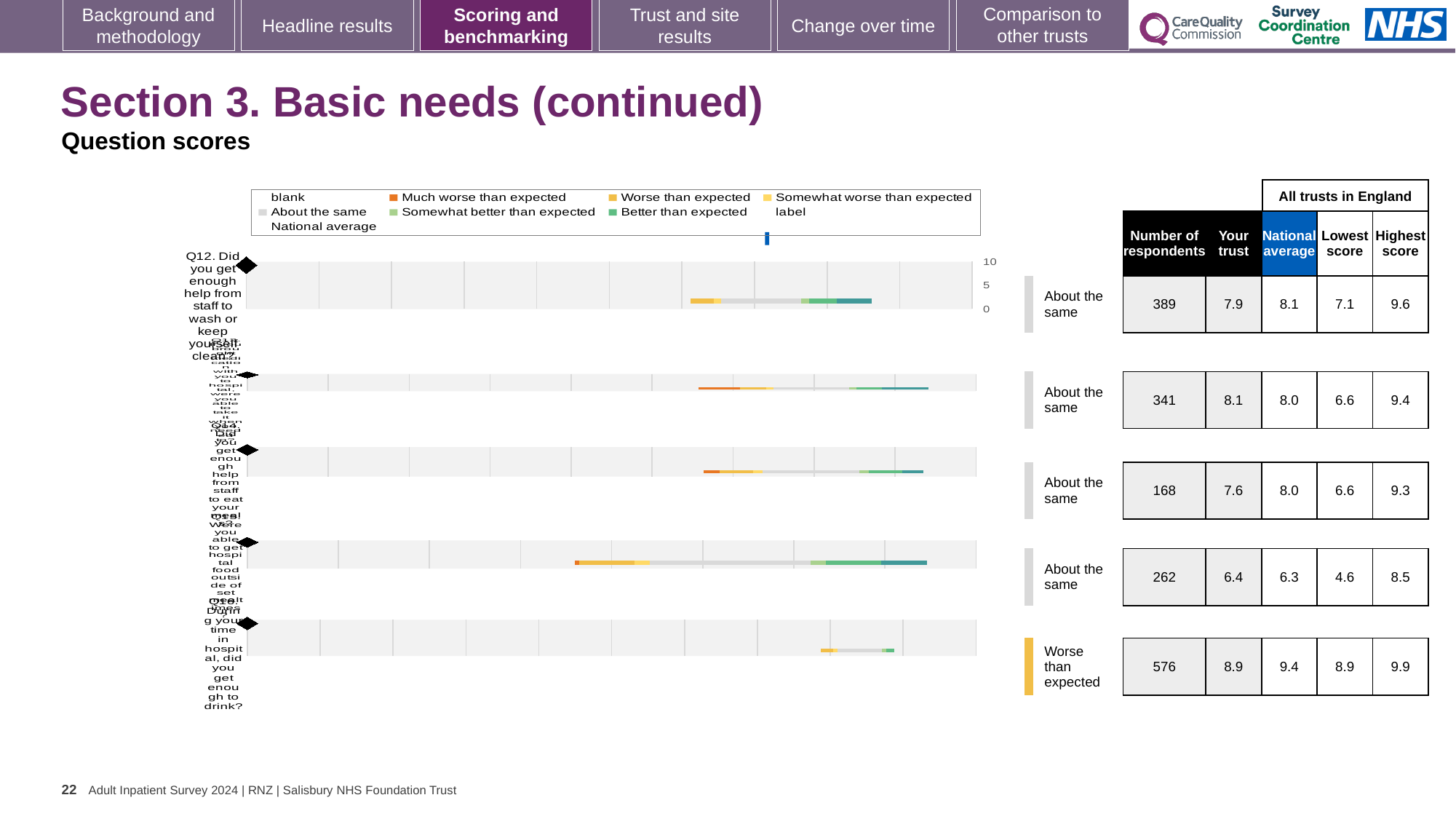
What benchmark category is shown for the first row (Q12, help from staff to wash or keep yourself clean)? About the same What is the difference between the highest score and lowest score for the first row (Q12)? 2.5 How many horizontal bars (question rows) are plotted in the chart? 5 What is the maximum value shown on the chart's score axis? 10 Which row has the lowest 'Your trust' score? the fourth row (Q15) What benchmark category is shown for the last row (Q16, did you get enough to drink)? Worse than expected What kind of chart is shown on the slide? bar chart Which colour does the legend use for 'Much worse than expected'? orange Is the 'Your trust' score for the last row (Q16) greater or less than the national average? less How many respondents are listed for the last row (Q16)? 576 What is the 'Your trust' score for the first row (Q12)? 7.9 What is the national average for the last row (Q16)? 9.4